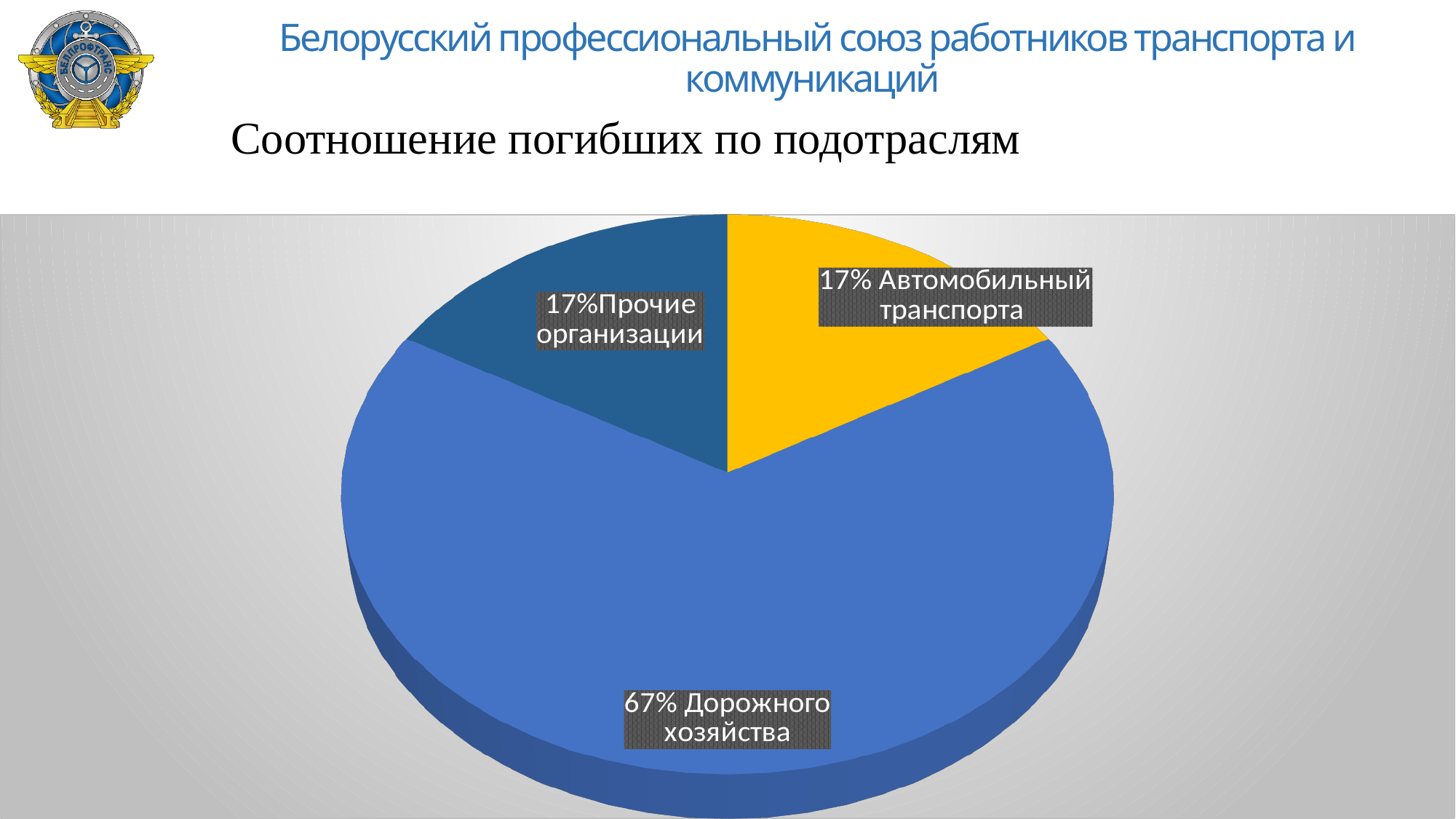
Which category has the largest slice of the pie? Дорожного хозяйства What is the difference in percentage points between "Дорожного хозяйства" and "Прочие организации"? 50 What share of the pie does "Прочие организации" have? 17% What share of the pie does "Дорожного хозяйства" have? 67% What share of the pie does "Автомобильный транспорта" have? 17% Is the share for "Дорожного хозяйства" greater or less than 50%? greater Which is larger: the slice for "Дорожного хозяйства" or the slice for "Автомобильный транспорта"? Дорожного хозяйства What kind of chart is shown on the slide? Pie chart What colour is the slice for "Автомобильный транспорта"? Yellow What is the title of the chart? Соотношение погибших по подотраслям How many slices does the pie chart have? 3